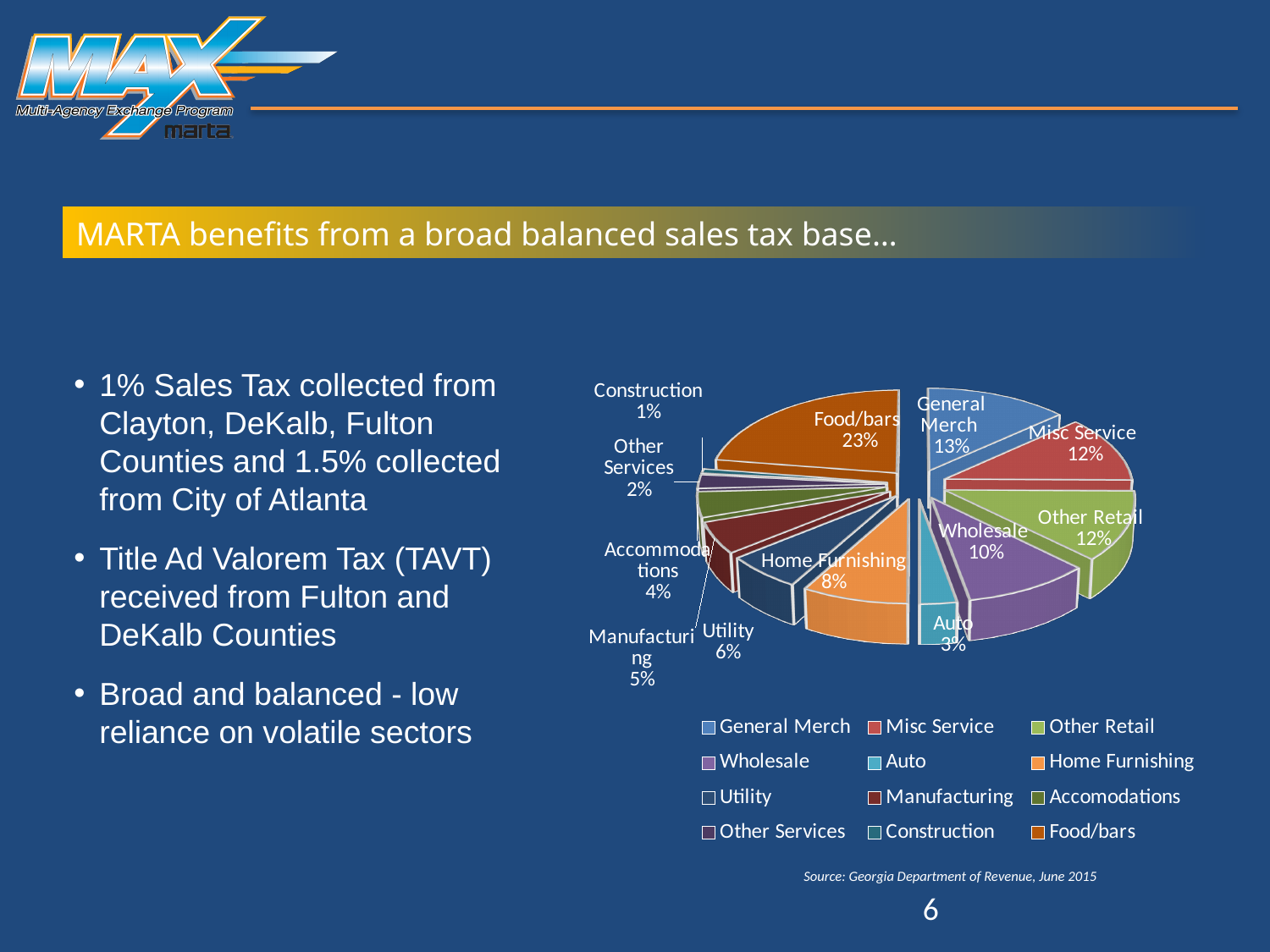
Which category has the largest slice of the pie? Food/bars What share of the pie does Food/bars account for? 23% How many entries does the legend list? 12 What percentage is shown for Home Furnishing? 8% What kind of chart is shown on the slide? Pie chart What percentage is shown for Wholesale? 10% How many categories are shown in the pie chart? 12 Which is larger, the share for Utility or the share for Manufacturing? Utility What is the source cited below the chart? Georgia Department of Revenue, June 2015 Which category has the smallest slice of the pie? Construction What is the difference in percentage points between Food/bars and General Merch? 10 What percentage is shown for General Merch? 13%